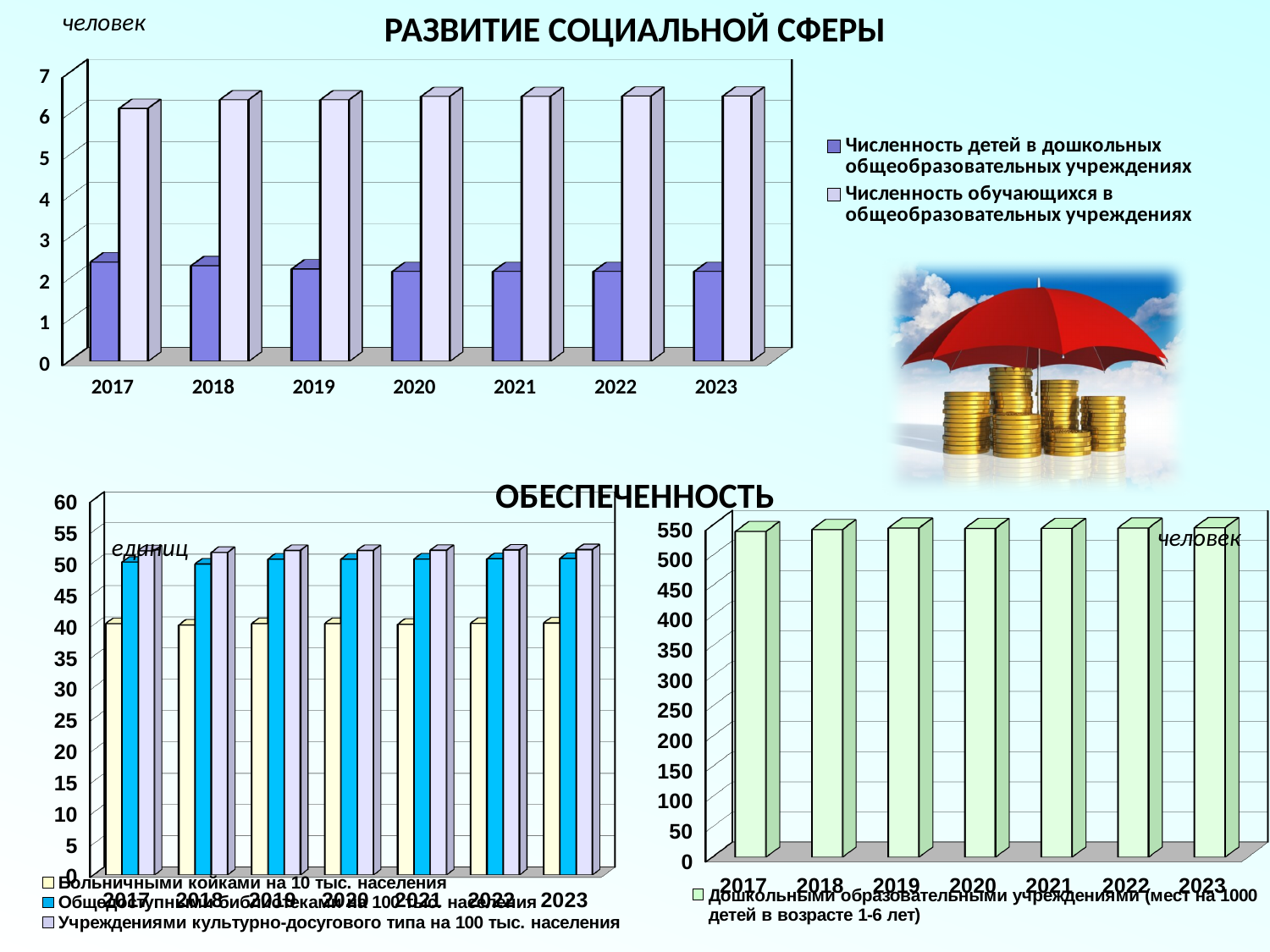
In the bottom-left chart, how many series does the legend list? 3 In the top chart 'РАЗВИТИЕ СОЦИАЛЬНОЙ СФЕРЫ', is the value for 'Численность детей в дошкольных общеобразовательных учреждениях' in 2023 greater or less than 3? less In the bottom-right chart, how many years are shown on the x axis? 7 In the top chart 'РАЗВИТИЕ СОЦИАЛЬНОЙ СФЕРЫ', is the value for 'Численность обучающихся в общеобразовательных учреждениях' in 2017 greater or less than 5? greater In the top chart 'РАЗВИТИЕ СОЦИАЛЬНОЙ СФЕРЫ', which series has the larger value in 2020? Численность обучающихся в общеобразовательных учреждениях In the bottom-left chart, which is larger in 2019: 'Общедоступными библиотеками на 100 тыс. населения' or 'Больничными койками на 10 тыс. населения'? Общедоступными библиотеками на 100 тыс. населения In the top chart 'РАЗВИТИЕ СОЦИАЛЬНОЙ СФЕРЫ', does the series 'Численность детей в дошкольных общеобразовательных учреждениях' rise or fall from 2017 to 2023? fall In the top chart 'РАЗВИТИЕ СОЦИАЛЬНОЙ СФЕРЫ', how many years are shown on the x axis? 7 In the bottom-left chart, is the value for 'Больничными койками на 10 тыс. населения' in 2017 greater or less than 45? less In the top chart 'РАЗВИТИЕ СОЦИАЛЬНОЙ СФЕРЫ', how many series does the legend list? 2 What kind of chart is the top chart titled 'РАЗВИТИЕ СОЦИАЛЬНОЙ СФЕРЫ'? bar chart